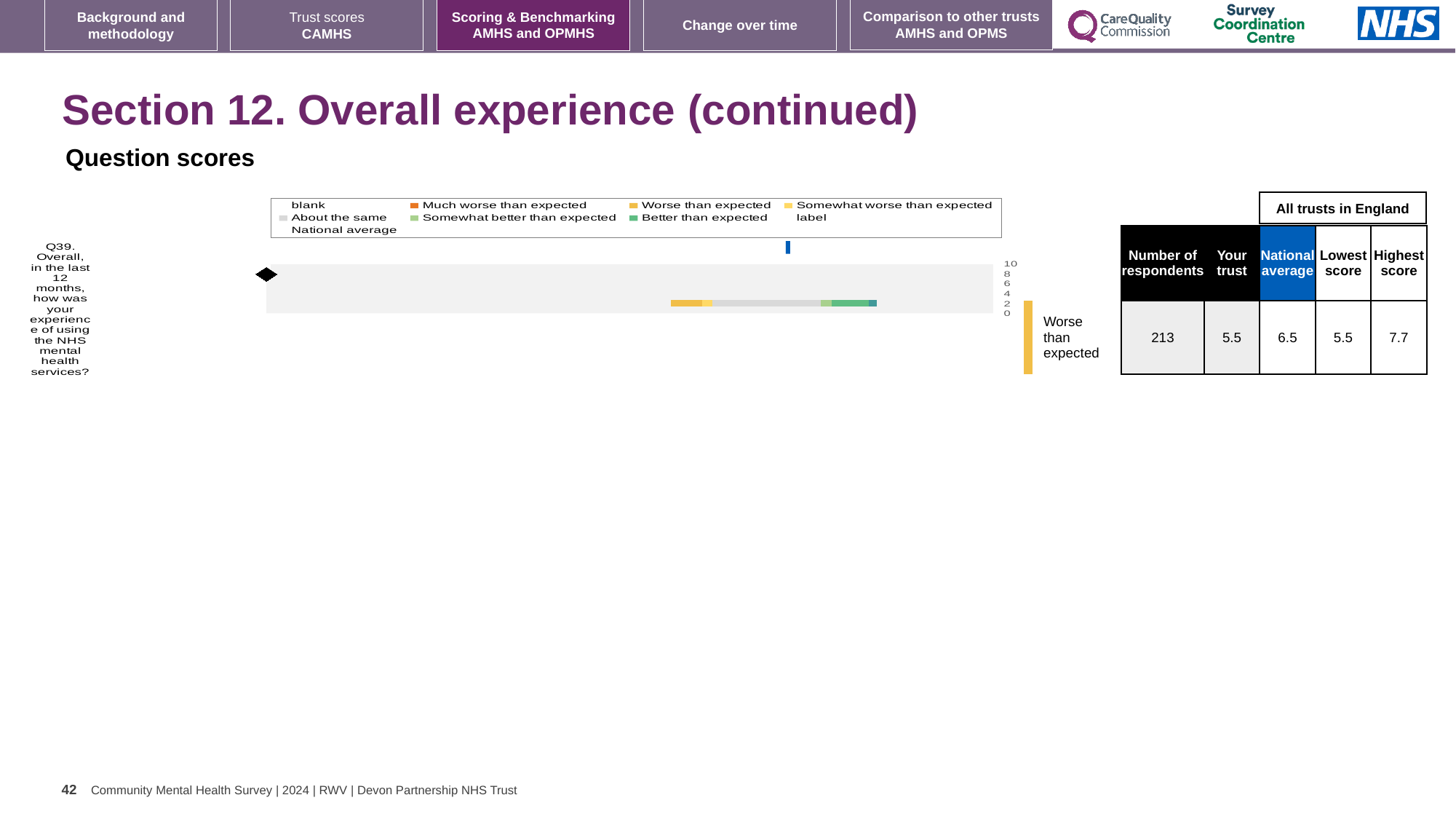
What is the national average score for Q39? 6.5 What is the difference between the highest and lowest scores for Q39? 2.2 What is the 'Your trust' score for Q39? 5.5 How many questions are plotted on the chart? 1 What kind of chart is used to show the Q39 question score? bar chart What benchmark rating is shown next to the chart for Q39? Worse than expected How many entries does the chart legend list? 9 How many respondents answered Q39? 213 What is the highest score among all trusts in England for Q39? 7.7 By how much does the national average exceed the 'Your trust' score for Q39? 1.0 Which is larger for Q39, the 'Your trust' score or the national average? National average What is the lowest score among all trusts in England for Q39? 5.5